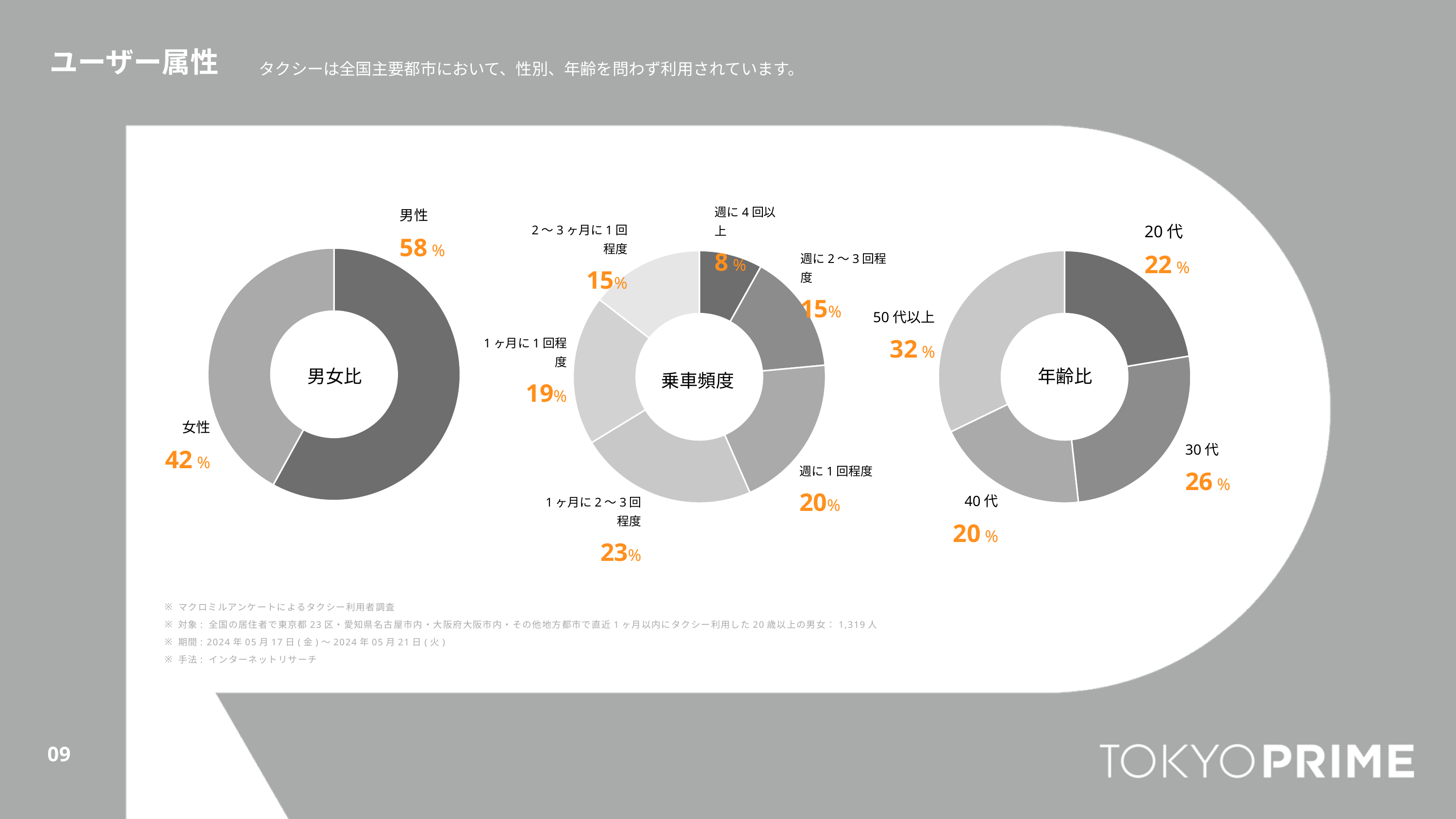
In the 年齢比 chart, what percentage is 30 代? 26% In the 乗車頻度 chart, what percentage is 週に 4 回以上? 8% In the 男女比 chart, what percentage is 男性? 58% In the 男女比 chart, what percentage is 女性? 42% In the 男女比 chart, what is the difference between 男性 and 女性? 16% In the 乗車頻度 chart, which category has the largest share? 1 ヶ月に 2 〜 3 回程度 In the 乗車頻度 chart, how many categories are shown? 6 In the 乗車頻度 chart, what percentage is 1 ヶ月に 1 回程度? 19% What type of chart is the 年齢比 chart? Donut chart In the 年齢比 chart, which is larger, 20 代 or 40 代? 20 代 In the 乗車頻度 chart, which category has the smallest share? 週に 4 回以上 In the 年齢比 chart, which age group has the largest share? 50 代以上